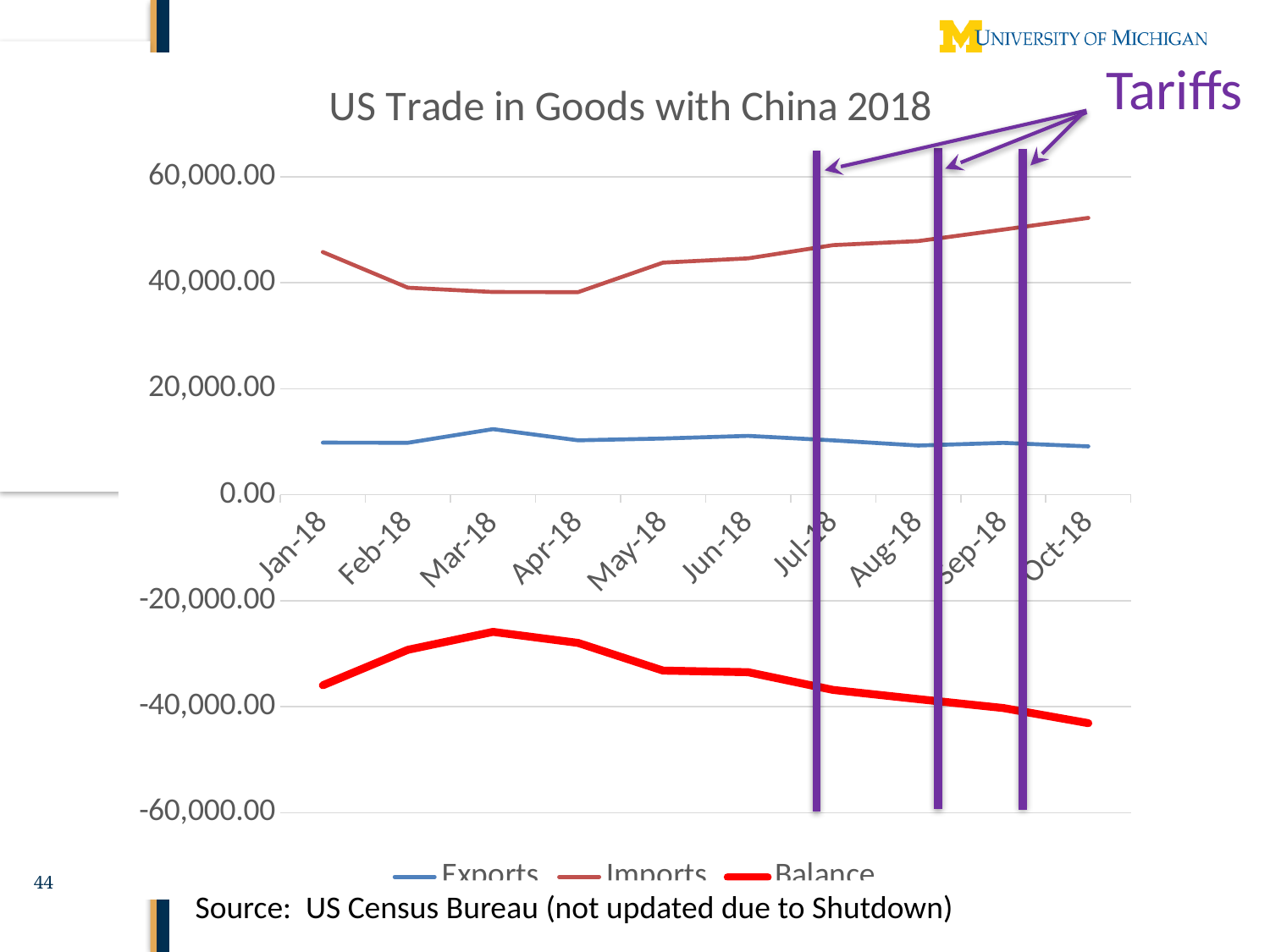
In which month is the Balance lowest? Oct-18 What kind of chart is shown on the slide? Line chart Is the value for Balance in Oct-18 greater or less than -40,000.00? less In which month are Exports highest? Mar-18 What is the title of the chart? US Trade in Goods with China 2018 Is the value for Imports in Oct-18 greater or less than 40,000.00? greater Which is larger in Jan-18, Imports or Exports? Imports Do Imports rise or fall from Apr-18 to Oct-18? Rise Which series is drawn with the thick red line? Balance In which month are Imports highest? Oct-18 How many series does the legend list? 3 How many months are plotted along the x axis? 10